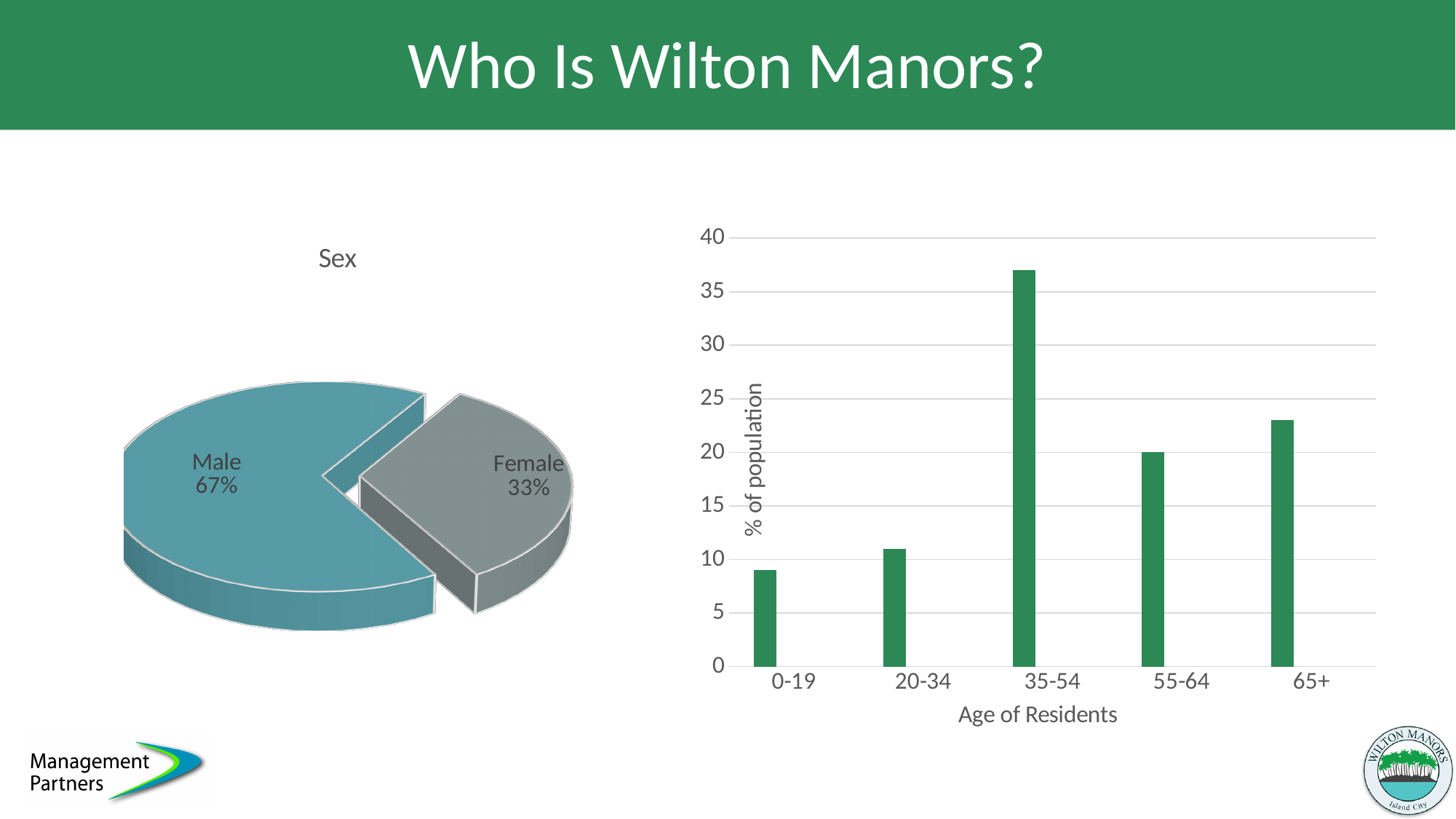
In the bar chart on the right, which age group has a higher % of population, 65+ or 55-64? 65+ In the pie chart titled Sex, what share of the population is Male? 67% In the pie chart titled Sex, which slice is larger, Male or Female? Male In the bar chart on the right, which age group has the highest % of population? 35-54 In the bar chart on the right, which age group has the lowest % of population? 0-19 In the pie chart titled Sex, what share of the population is Female? 33% In the pie chart titled Sex, how many slices are there? 2 In the bar chart on the right, how many age groups are shown on the x axis? 5 In the bar chart on the right, is the value for 35-54 greater or less than 35? greater In the bar chart on the right, is the value for 0-19 greater or less than 10? less What kind of chart is the chart on the right showing Age of Residents? bar chart In the pie chart titled Sex, what is the difference in percentage points between the Male and Female slices? 34